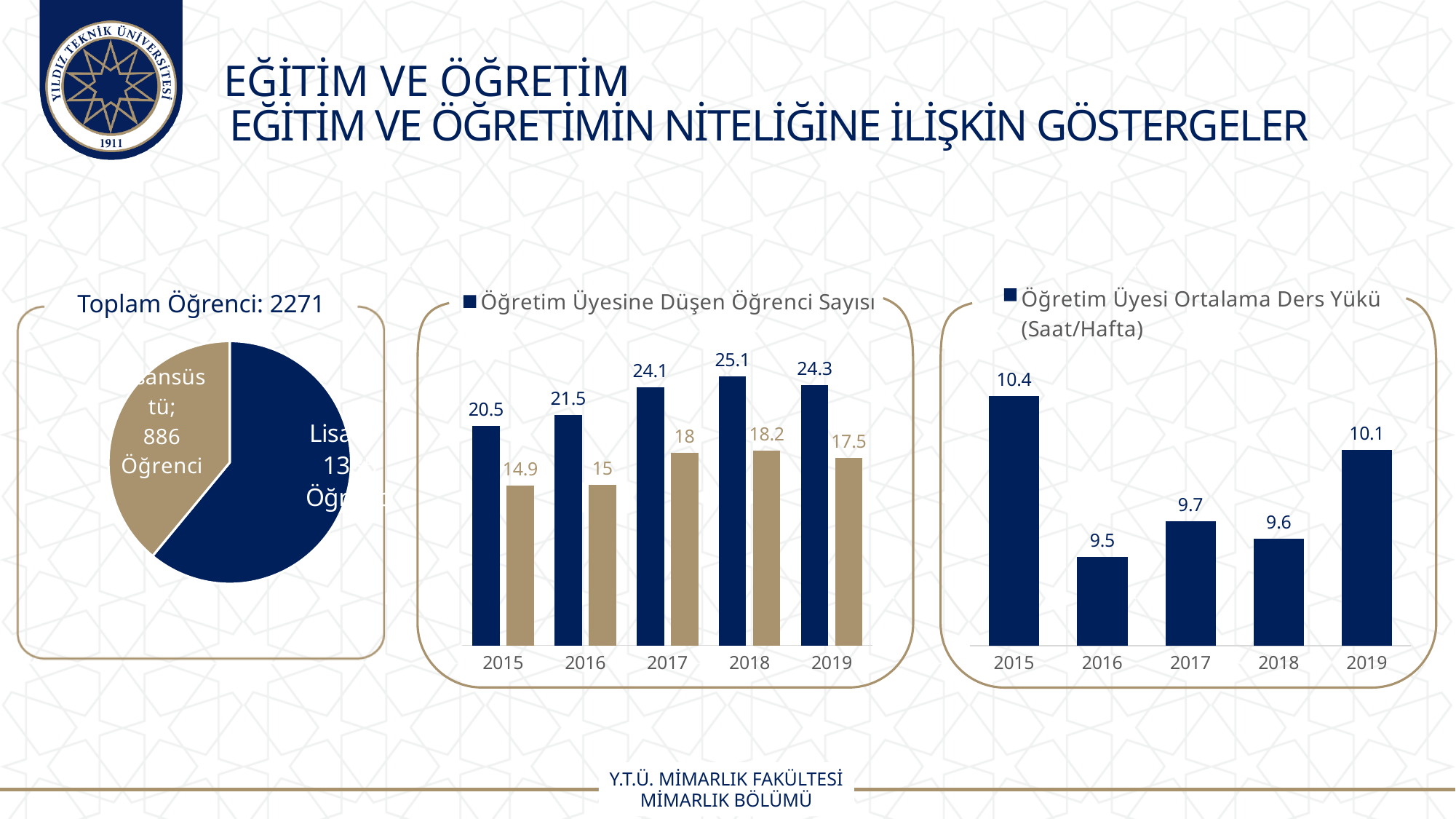
On the 'Öğretim Üyesi Ortalama Ders Yükü (Saat/Hafta)' chart, what is the value for 2015? 10.4 On the 'Toplam Öğrenci: 2271' pie chart, how many students are in the Lisansüstü slice? 886 On the 'Öğretim Üyesine Düşen Öğrenci Sayısı' chart, which year has the highest dark blue bar? 2018 On the 'Öğretim Üyesi Ortalama Ders Yükü (Saat/Hafta)' chart, which year has the highest value? 2015 What kind of chart is the 'Toplam Öğrenci: 2271' chart? pie chart On the 'Öğretim Üyesi Ortalama Ders Yükü (Saat/Hafta)' chart, what is the difference between the 2015 and 2016 values? 0.9 On the 'Öğretim Üyesi Ortalama Ders Yükü (Saat/Hafta)' chart, which year has the lowest value? 2016 On the 'Öğretim Üyesine Düşen Öğrenci Sayısı' chart, what is the value of the dark blue bar for 2018? 25.1 On the 'Öğretim Üyesine Düşen Öğrenci Sayısı' chart, what is the value of the tan bar for 2015? 14.9 On the 'Öğretim Üyesine Düşen Öğrenci Sayısı' chart, is the tan bar for 2017 larger or smaller than the tan bar for 2018? smaller On the 'Öğretim Üyesine Düşen Öğrenci Sayısı' chart, what is the difference between the dark blue and tan bars for 2019? 6.8 On the 'Öğretim Üyesi Ortalama Ders Yükü (Saat/Hafta)' chart, how many years are shown on the x axis? 5